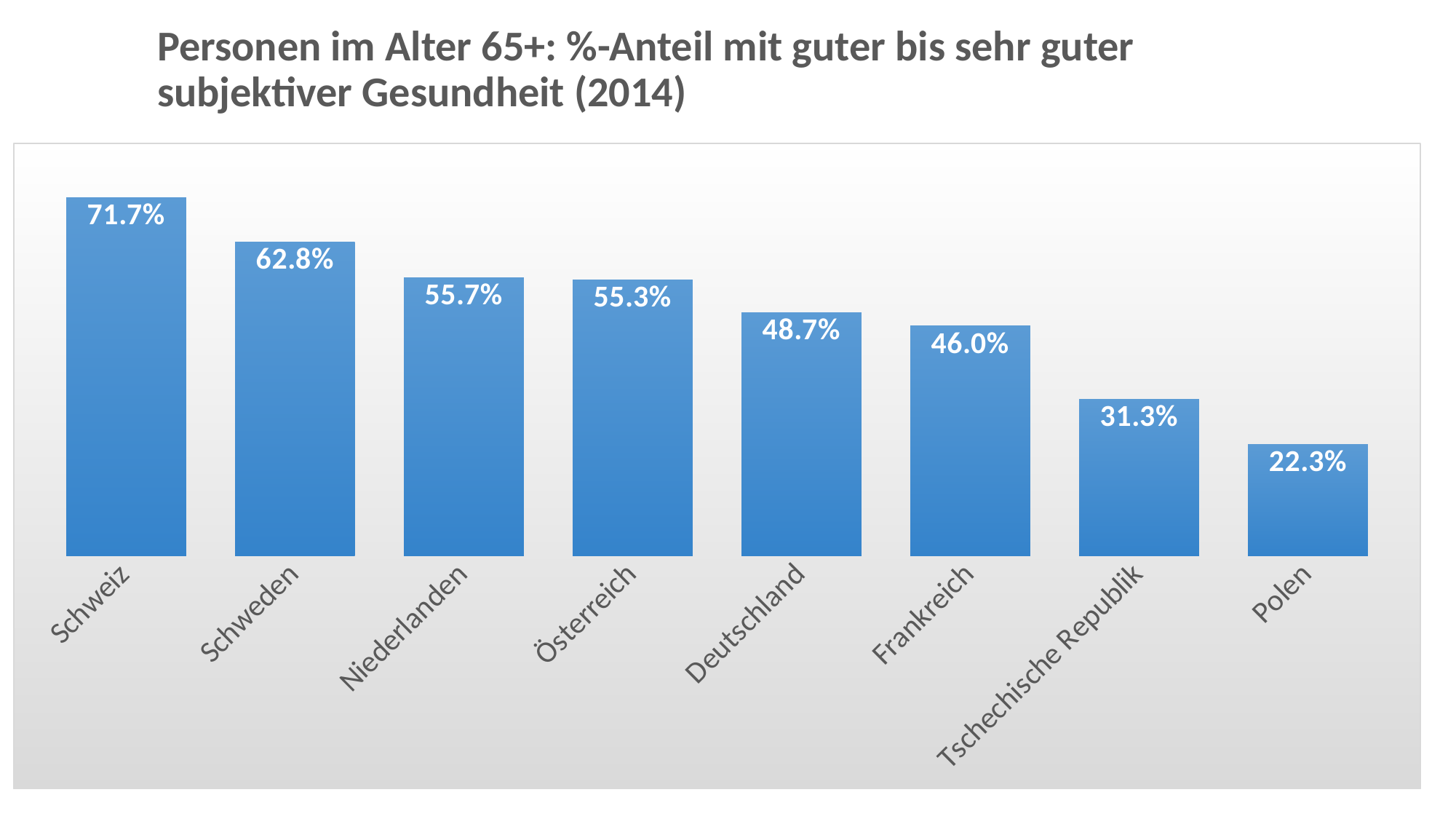
What is the difference between the values for Schweden and Frankreich? 16.8% How many countries are shown in the chart? 8 Which has a larger value, Niederlanden or Österreich? Niederlanden What is the value for Deutschland? 48.7% What kind of chart is shown on the slide? Bar chart What is the value for Schweiz? 71.7% Which has a larger value, Frankreich or Deutschland? Deutschland Which country has the highest value? Schweiz What is the difference between the values for Schweiz and Polen? 49.4% What is the value for Tschechische Republik? 31.3% Which country has the lowest value? Polen Do the values rise or fall from left to right along the x axis? Fall